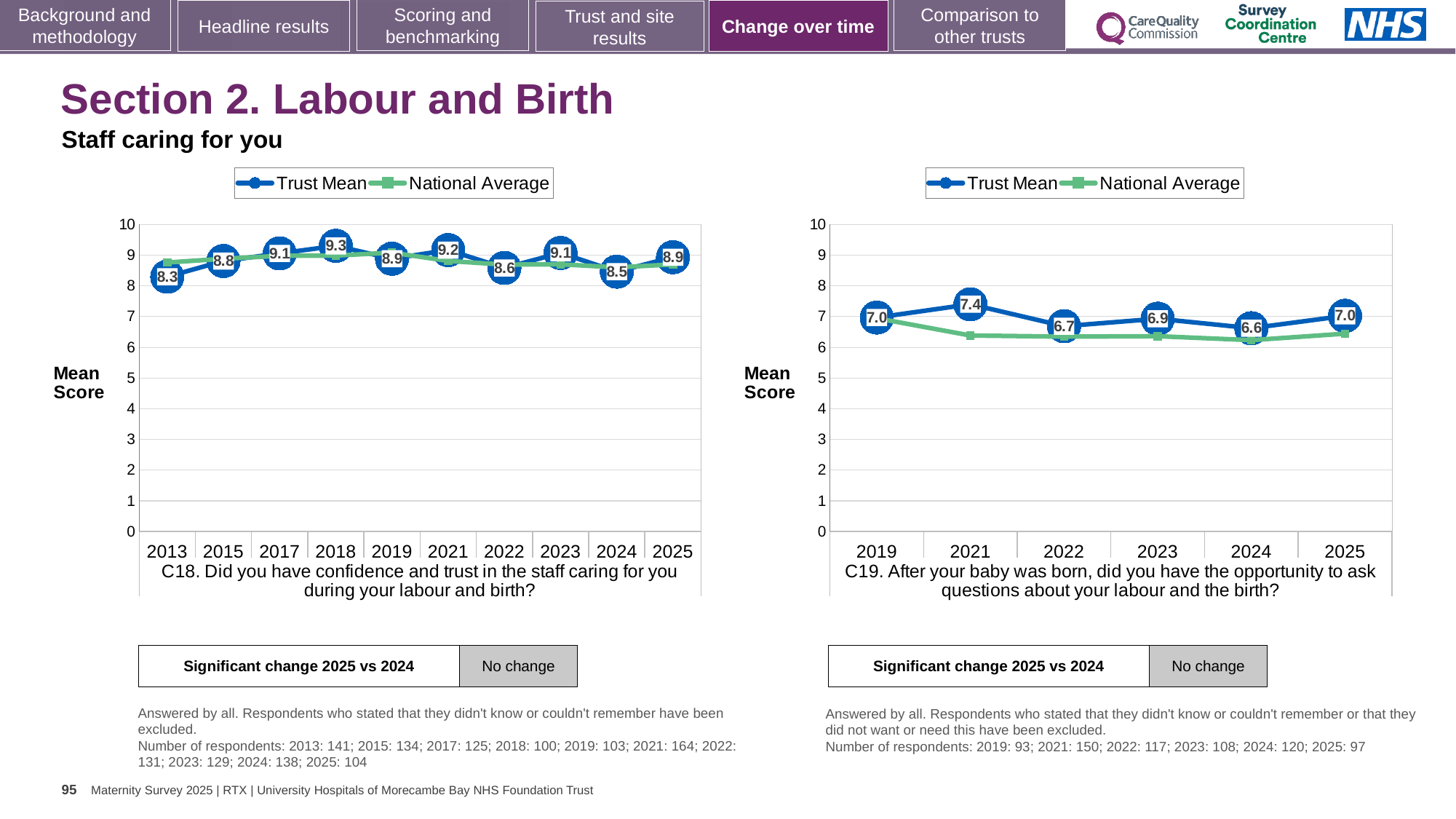
In the C18 chart (left), which year has the highest Trust Mean score? 2018 In the C19 chart (right), what is the Trust Mean score for 2021? 7.4 In the C19 chart (right), is the National Average for 2024 greater or less than 7? less In the C19 chart (right), is the Trust Mean score for 2021 higher or lower than for 2022? higher In the C18 chart (left), how many years are plotted on the x axis? 10 In the C18 chart (left), what is the Trust Mean score for 2013? 8.3 In the C18 chart (left), what is the difference between the Trust Mean scores for 2018 and 2024? 0.8 What type of chart is the C18 chart on the left? Line chart In the C19 chart (right), how many series does the legend list? 2 In the C18 chart (left), what is the Trust Mean score for 2018? 9.3 In the C19 chart (right), which year has the lowest Trust Mean score? 2024 In the C18 chart (left), which year has the lowest Trust Mean score? 2013